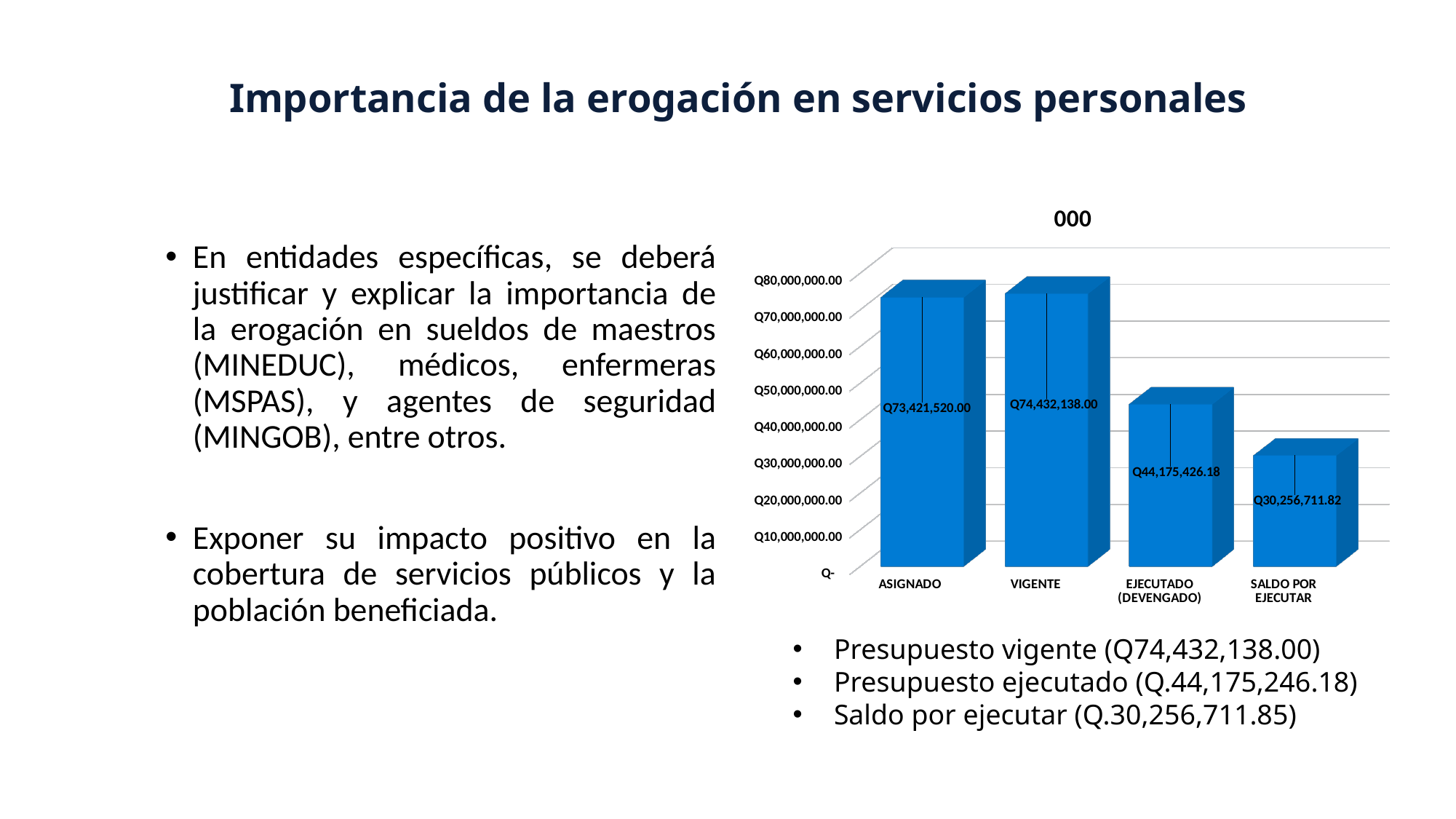
Which category has the highest value in the chart? VIGENTE What is the value for ASIGNADO in the chart? Q73,421,520.00 What is the value for SALDO POR EJECUTAR in the chart? Q30,256,711.82 How many categories are shown in the chart? 4 What is the value for VIGENTE in the chart? Q74,432,138.00 Which category has the lowest value in the chart? SALDO POR EJECUTAR Which is larger, the value for EJECUTADO (DEVENGADO) or the value for SALDO POR EJECUTAR? EJECUTADO (DEVENGADO) What kind of chart is shown on the slide? bar chart What is the value for EJECUTADO (DEVENGADO) in the chart? Q44,175,426.18 Is the value for SALDO POR EJECUTAR greater or less than Q40,000,000.00? less What is the difference between the VIGENTE and ASIGNADO values? Q1,010,618.00 What is the difference between the VIGENTE and EJECUTADO (DEVENGADO) values? Q30,256,711.82